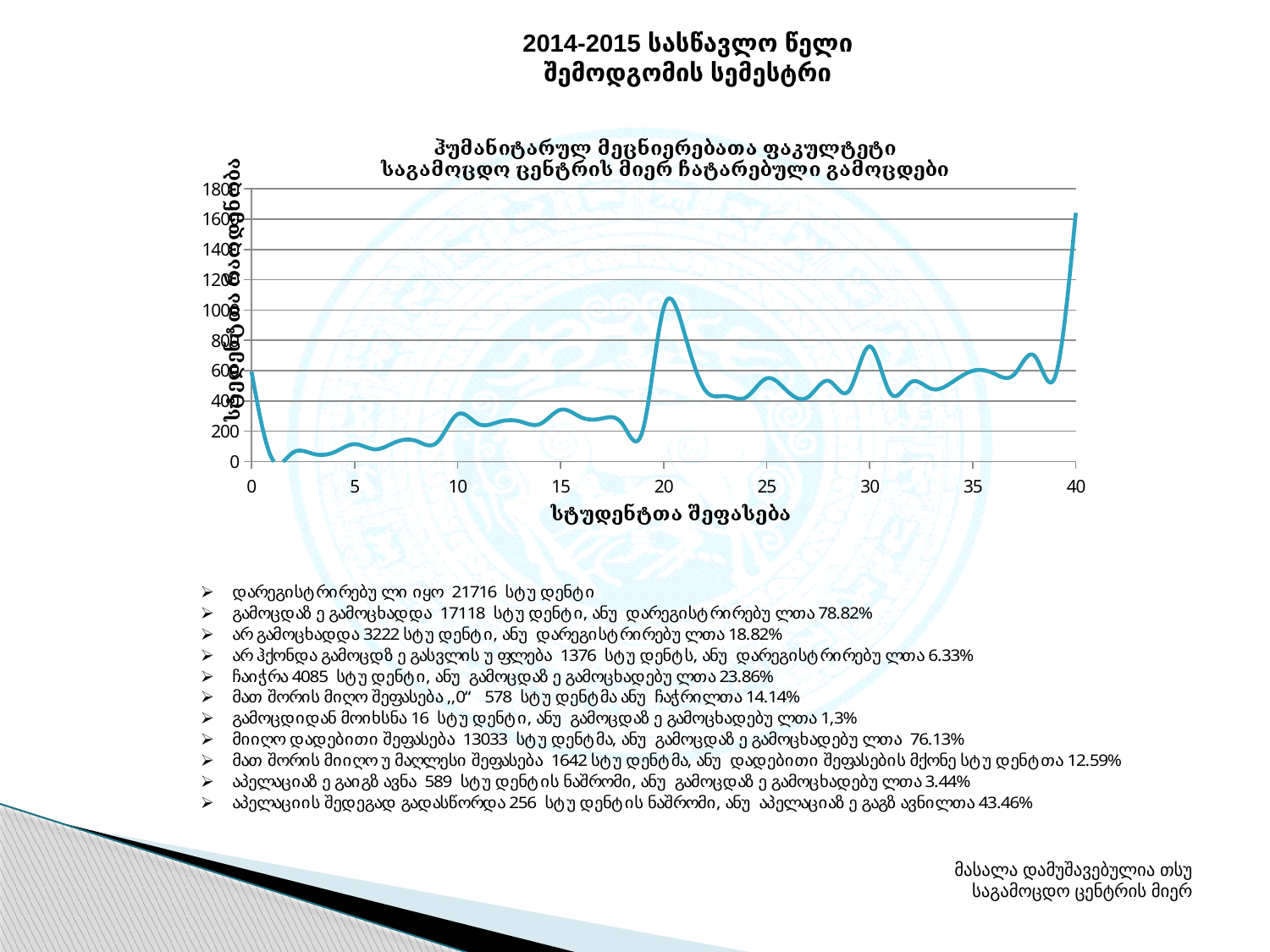
Is the value of the line at score 5 greater or less than 200? less Does the line rise or fall between score 35 and score 40? rise At which score on the x axis does the line reach its highest value? 40 Is the value of the line at score 20 greater or less than 800? greater Which has a higher value on the line: score 20 or score 30? score 20 What is the title of the chart? ჰუმანიტარულ მეცნიერებათა ფაკულტეტი საგამოცდო ცენტრის მიერ ჩატარებული გამოცდები Which has a higher value on the line: score 0 or score 10? score 0 Is the value of the line at score 40 greater or less than 1400? greater What is the label of the x axis of the chart? სტუდენტთა შეფასება What kind of chart is shown on the slide? line chart